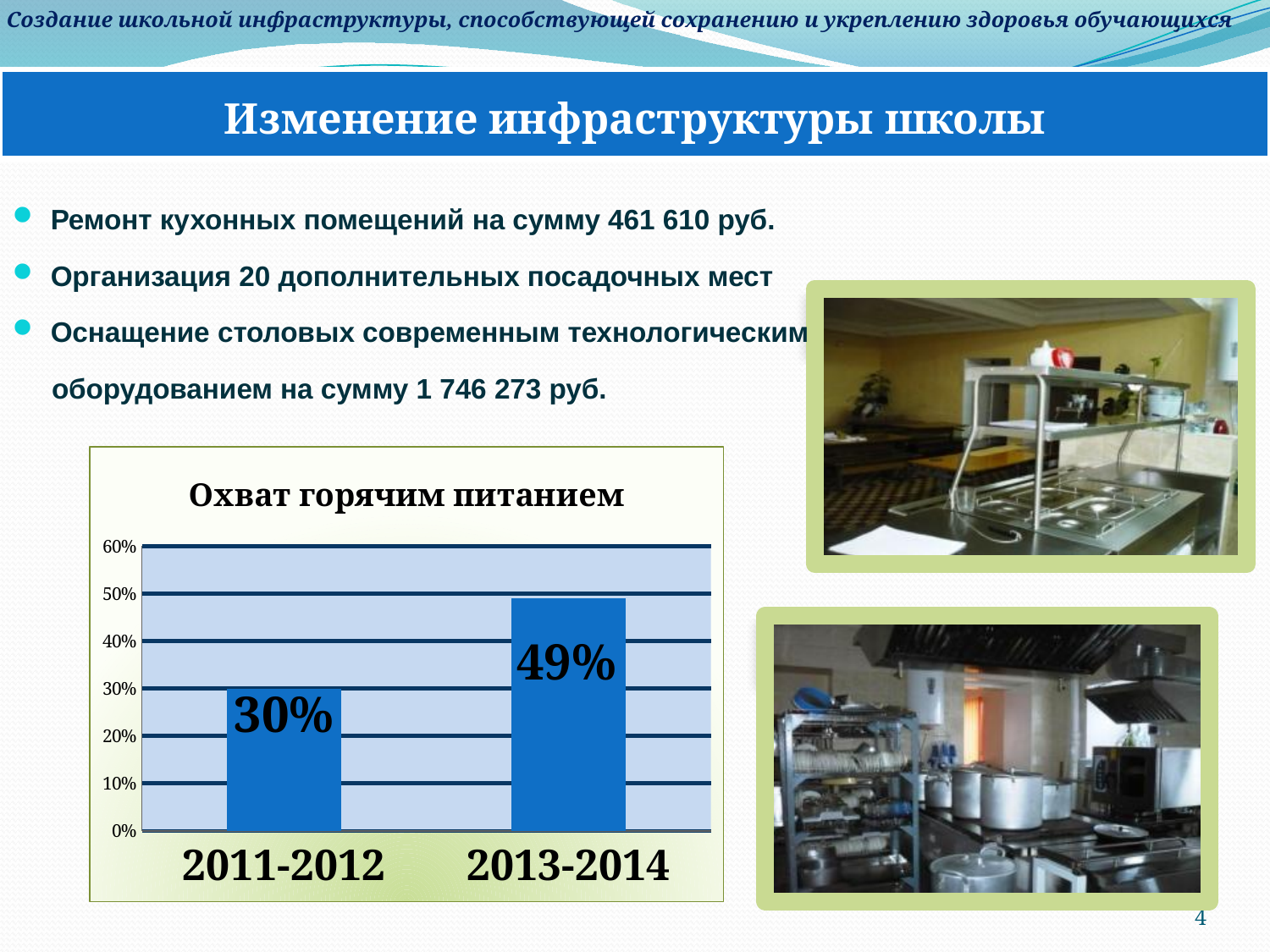
What is the difference between the values for 2013-2014 and 2011-2012? 19% Which is larger, the value for 2011-2012 or the value for 2013-2014? 2013-2014 What kind of chart is shown on the slide? bar chart Is the value for 2011-2012 greater or less than 40%? less Which category has the lowest value in the chart? 2011-2012 Which category has the highest value in the chart? 2013-2014 What is the title of the chart? Охват горячим питанием What is the value for 2011-2012 in the chart? 30% How many categories are shown in the chart? 2 What is the value for 2013-2014 in the chart? 49% Do the values rise or fall from 2011-2012 to 2013-2014? rise Is the value for 2013-2014 greater or less than 40%? greater